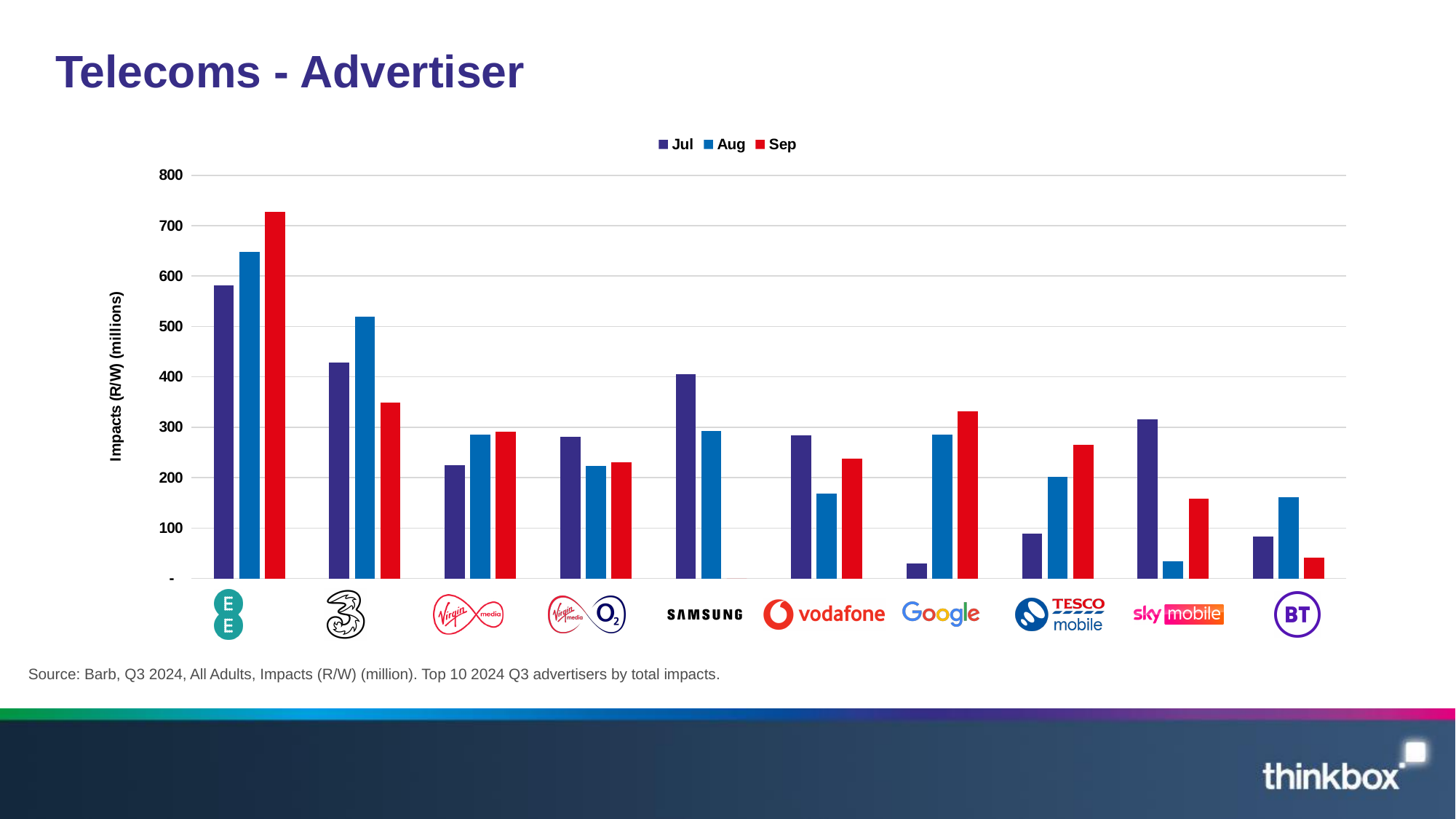
How many advertisers are shown on the x axis? 10 Is the Sep value for EE greater or less than 700? greater Is the Jul value for Google greater or less than 100? less Do the values for Google rise or fall from Jul to Sep? rise Which is larger, the Jul value for Samsung or the Jul value for Vodafone? Samsung Is the Aug value for Three greater or less than 500? greater Which advertiser has the lowest Jul value? Google How many series does the legend list? 3 What colour represents Sep in the legend? Red Do the values for EE rise or fall from Jul to Sep? rise What kind of chart is shown on the slide? Bar chart Which advertiser has the highest Sep value? EE